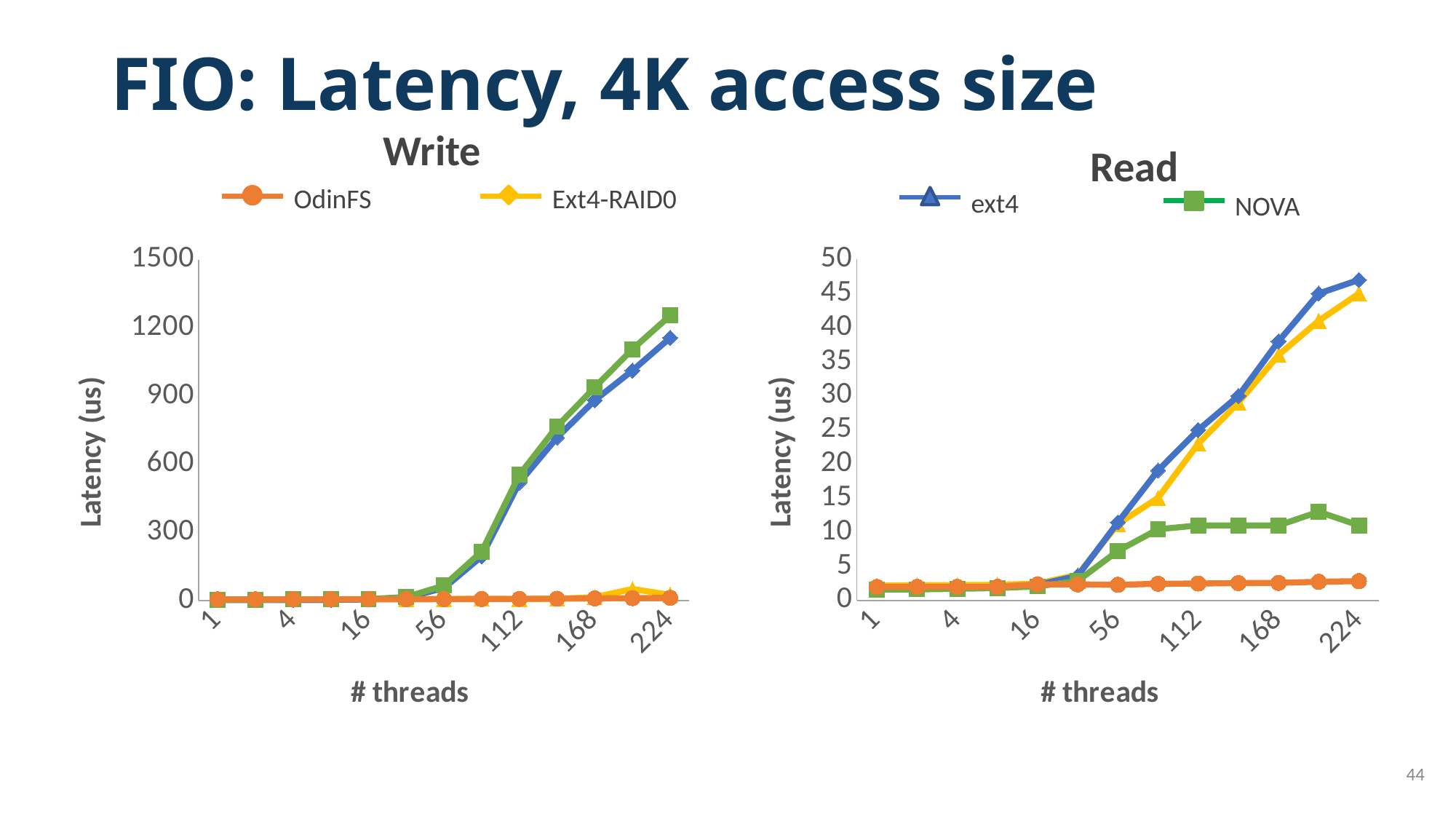
In the Write chart, is the value for NOVA at 224 threads greater or less than 1200? greater In the Read chart, which series has the highest latency at 224 threads? ext4 In the Read chart, is the value for NOVA at 224 threads greater or less than 15? less How many series does the legend list? 4 What kind of chart is the Write chart? line chart In the Write chart, does the latency for NOVA rise or fall as the number of threads increases? rise In the Write chart, which series has the highest latency at 224 threads? NOVA In the Read chart, is the value for ext4 at 224 threads greater or less than 45? greater In the Write chart, which series has the lowest latency at 224 threads? OdinFS What is the y-axis title of the Read chart? Latency (us)